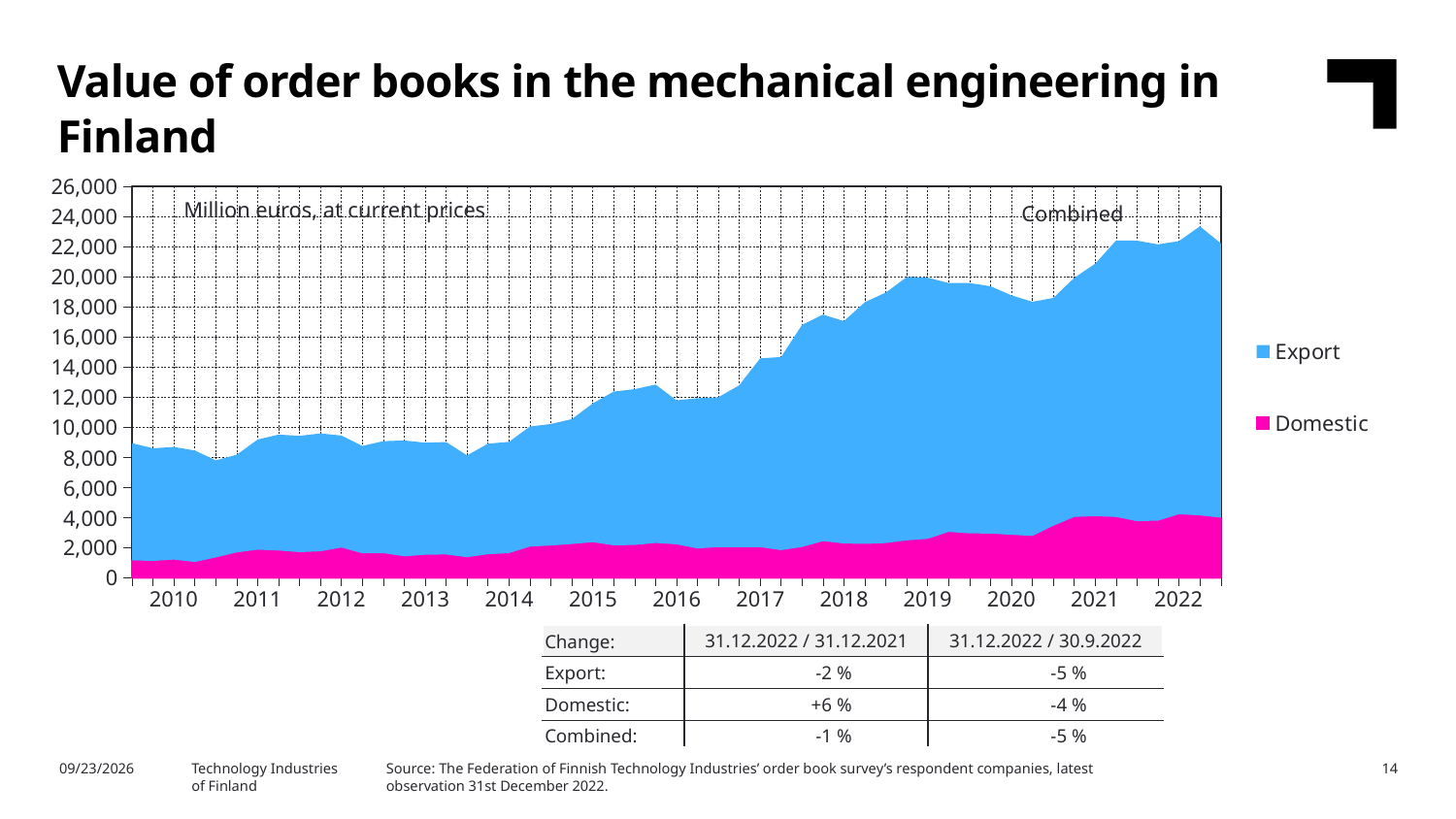
What unit is stated for the values in the chart? Million euros, at current prices How many years are labelled on the x axis of the chart? 13 How many series does the chart legend list? 2 Is the Domestic value at the end of 2022 greater or less than 2,000? greater Which series has the larger value in 2022, Export or Domestic? Export Does the combined value of order books generally rise or fall from 2010 to 2022? rise Is the Domestic value at the start of 2010 greater or less than 2,000? less Is the combined value of order books at the end of 2022 greater or less than 20,000? greater Which two series are listed in the chart legend? Export and Domestic What type of chart is shown on the slide? Area chart